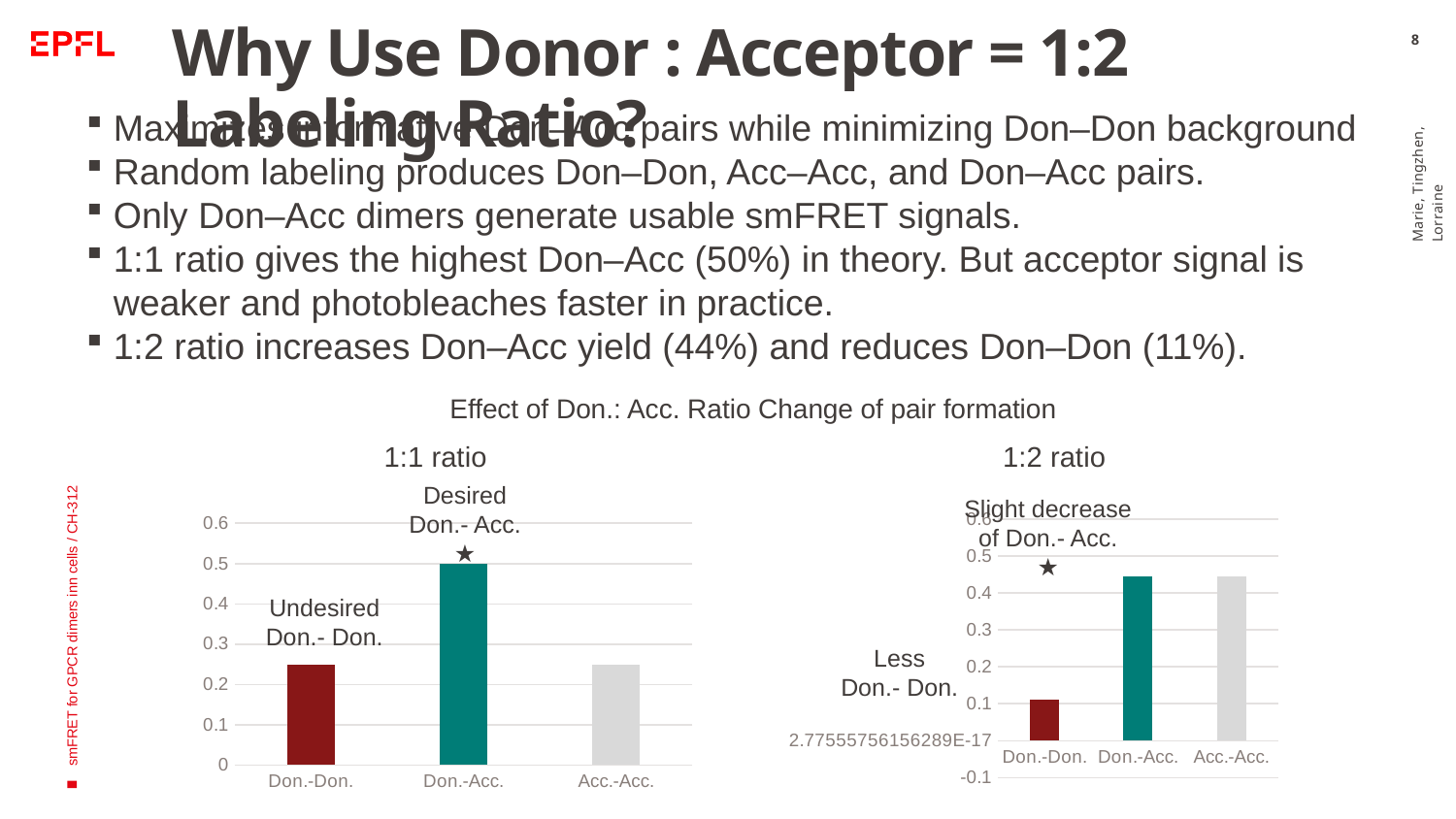
In the 1:1 ratio chart, what value does the Don.-Acc. bar reach on the y axis? 0.5 In the 1:1 ratio chart, which is larger, the Don.-Acc. bar or the Acc.-Acc. bar? Don.-Acc. How many categories are shown on the x axis of the 1:2 ratio chart? 3 What is the overall title shown above the two charts? Effect of Don.: Acc. Ratio Change of pair formation In the 1:2 ratio chart, is the value for Don.-Acc. greater or less than 0.4? greater In the 1:2 ratio chart, which category has the lowest bar? Don.-Don. In the 1:2 ratio chart, is the value for Don.-Don. greater or less than 0.2? less In the 1:2 ratio chart, which is larger, the Don.-Don. bar or the Acc.-Acc. bar? Acc.-Acc. In the 1:1 ratio chart, which category is labelled as 'Undesired'? Don.- Don. In the 1:1 ratio chart, which category has the highest bar? Don.-Acc. What kind of chart is the 1:1 ratio chart? bar chart In the 1:1 ratio chart, is the value for Don.-Don. greater or less than 0.3? less